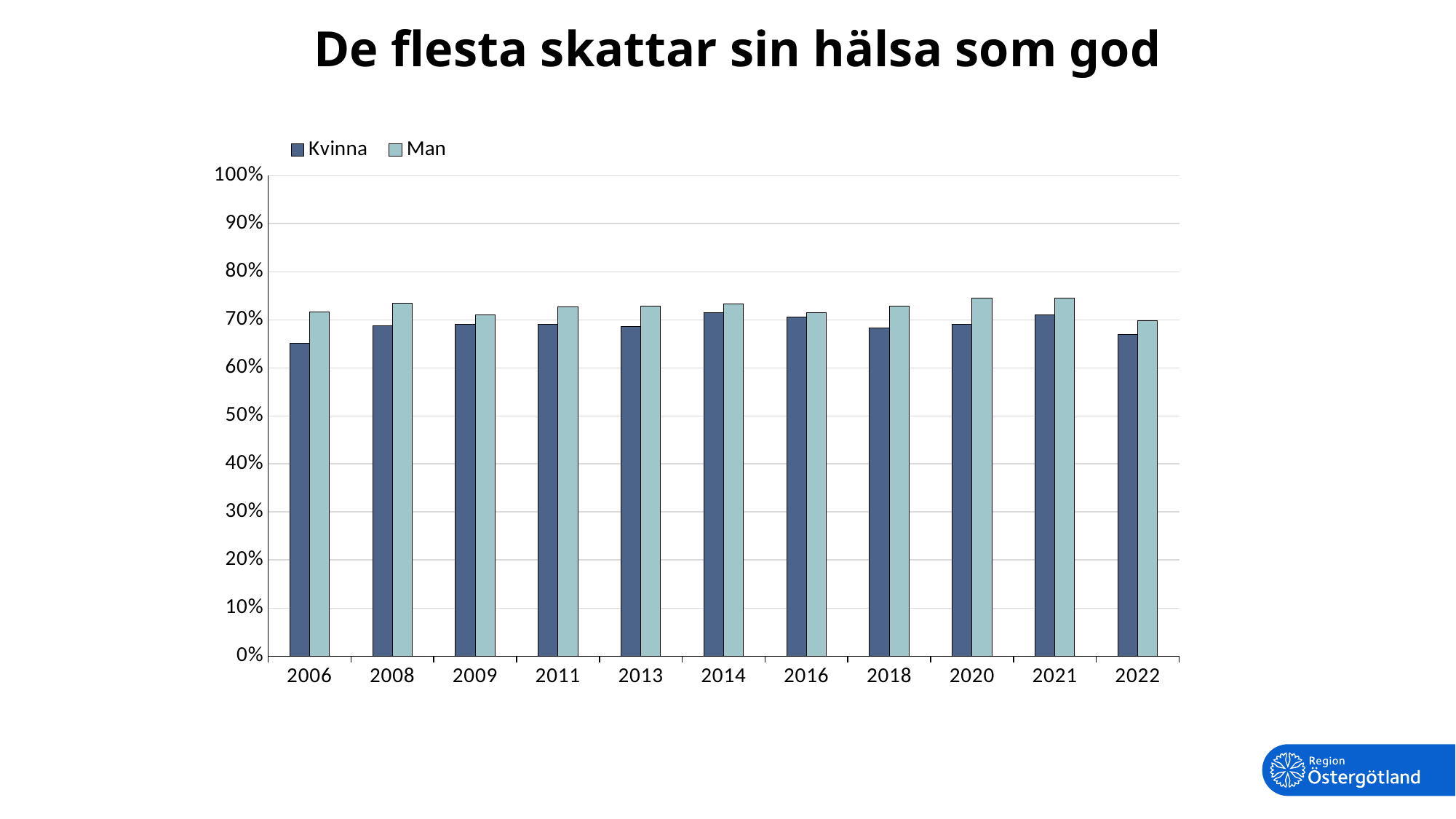
Is the value for Man in 2021 greater or less than 80%? less In which year is the value for Kvinna lowest? 2006 In which year is the value for Man lowest? 2022 What are the two series named in the legend? Kvinna and Man Is the value for Man in 2020 greater or less than 70%? greater Is the value for Kvinna in 2006 greater or less than 70%? less What is the title of the chart? De flesta skattar sin hälsa som god How many years are shown on the x axis? 11 How many series does the legend list? 2 What kind of chart is shown on the slide? Bar chart In 2006, which series has the larger value, Kvinna or Man? Man